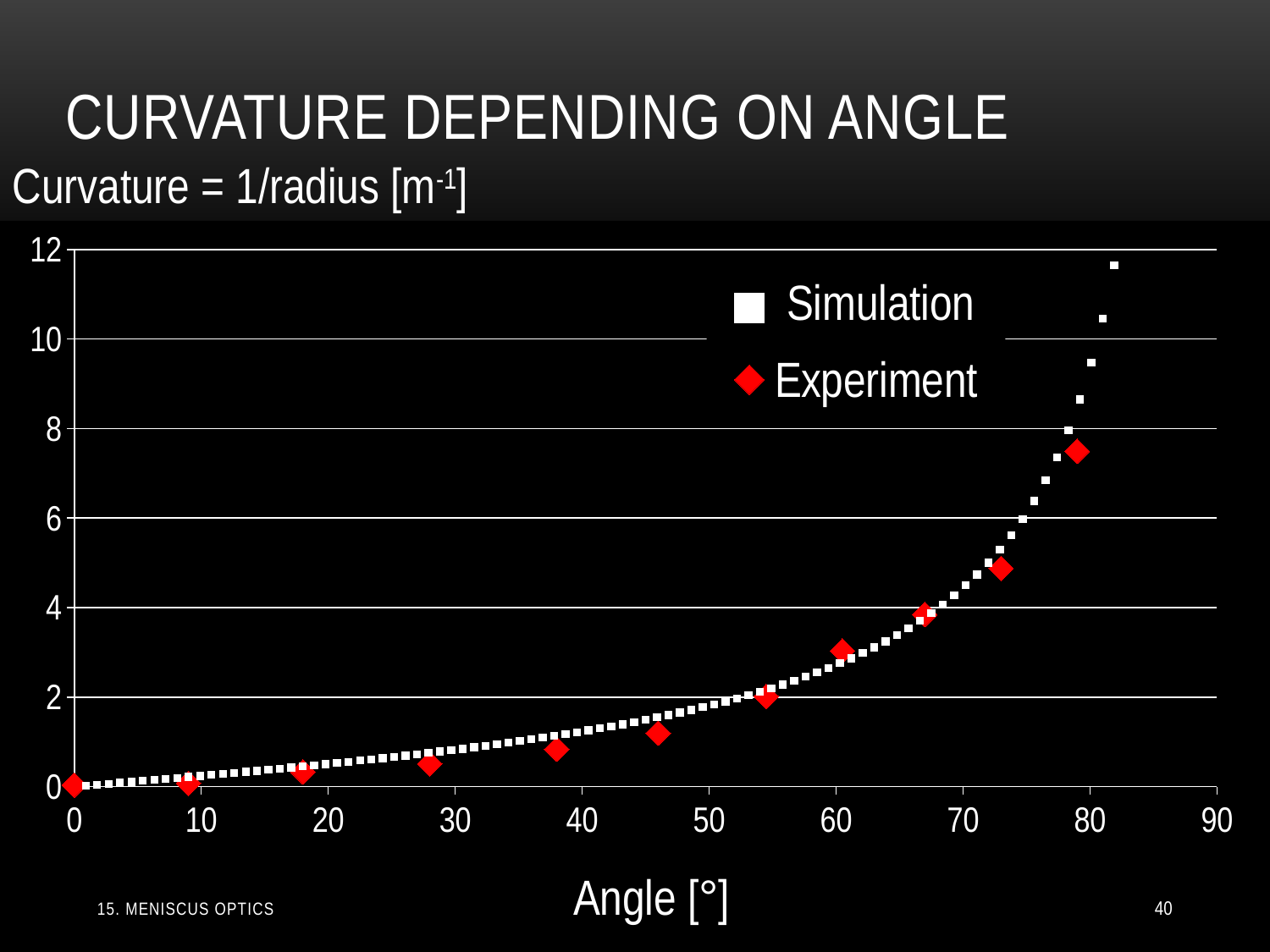
What are the two series named in the legend? Simulation and Experiment Is the Experiment value at an angle of about 60° greater or less than 2? greater Is the highest Simulation value greater or less than 10? greater Is the Experiment value at an angle of about 46° greater or less than 2? less What is the label of the x axis? Angle [°] Do the curvature values rise or fall as the angle increases? rise How many series does the legend list? 2 How many Experiment data points are plotted? 11 Which series reaches the highest curvature value on the chart? Simulation What kind of chart is shown on the slide? scatter chart